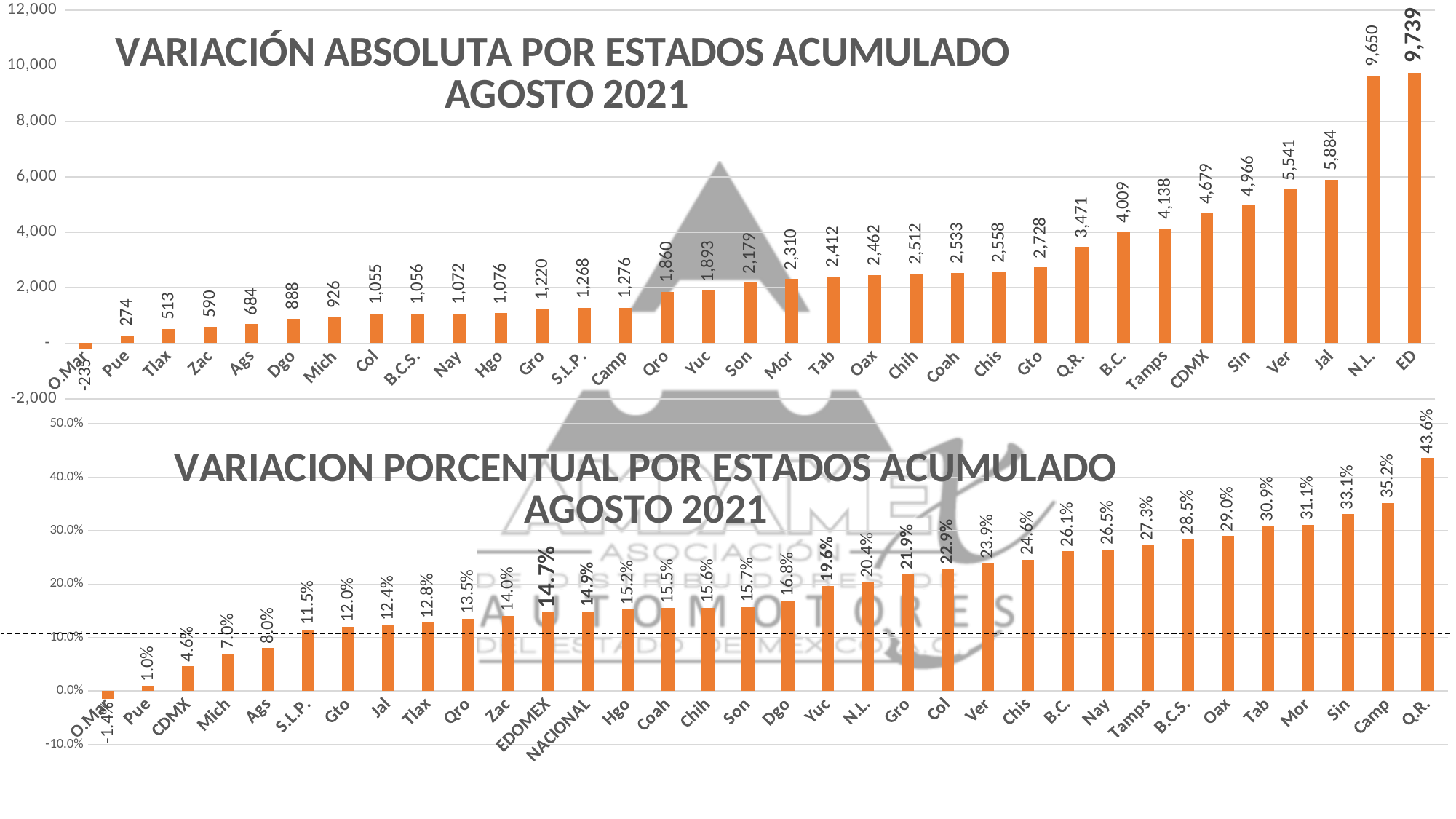
In the bottom chart (Variacion porcentual por estados acumulado agosto 2021), what is the value for NACIONAL? 14.9% What type of chart is the top chart (Variación absoluta por estados acumulado agosto 2021)? bar chart In the bottom chart (Variacion porcentual por estados acumulado agosto 2021), which is larger, the value for Camp or the value for Sin? Camp In the top chart (Variación absoluta por estados acumulado agosto 2021), what is the value for N.L.? 9,650 In the top chart (Variación absoluta por estados acumulado agosto 2021), which state has the highest value? ED In the top chart (Variación absoluta por estados acumulado agosto 2021), what is the difference between the values for Jal and Ver? 343 In the top chart (Variación absoluta por estados acumulado agosto 2021), what is the value for Tamps? 4,138 In the bottom chart (Variacion porcentual por estados acumulado agosto 2021), what is the difference between the values for Q.R. and Camp? 8.4% In the top chart (Variación absoluta por estados acumulado agosto 2021), which state has the lowest value? O.Mar In the bottom chart (Variacion porcentual por estados acumulado agosto 2021), what is the value for EDOMEX? 14.7% In the bottom chart (Variacion porcentual por estados acumulado agosto 2021), which state has the highest value? Q.R. In the top chart (Variación absoluta por estados acumulado agosto 2021), do the values rise or fall from left to right along the x axis? rise